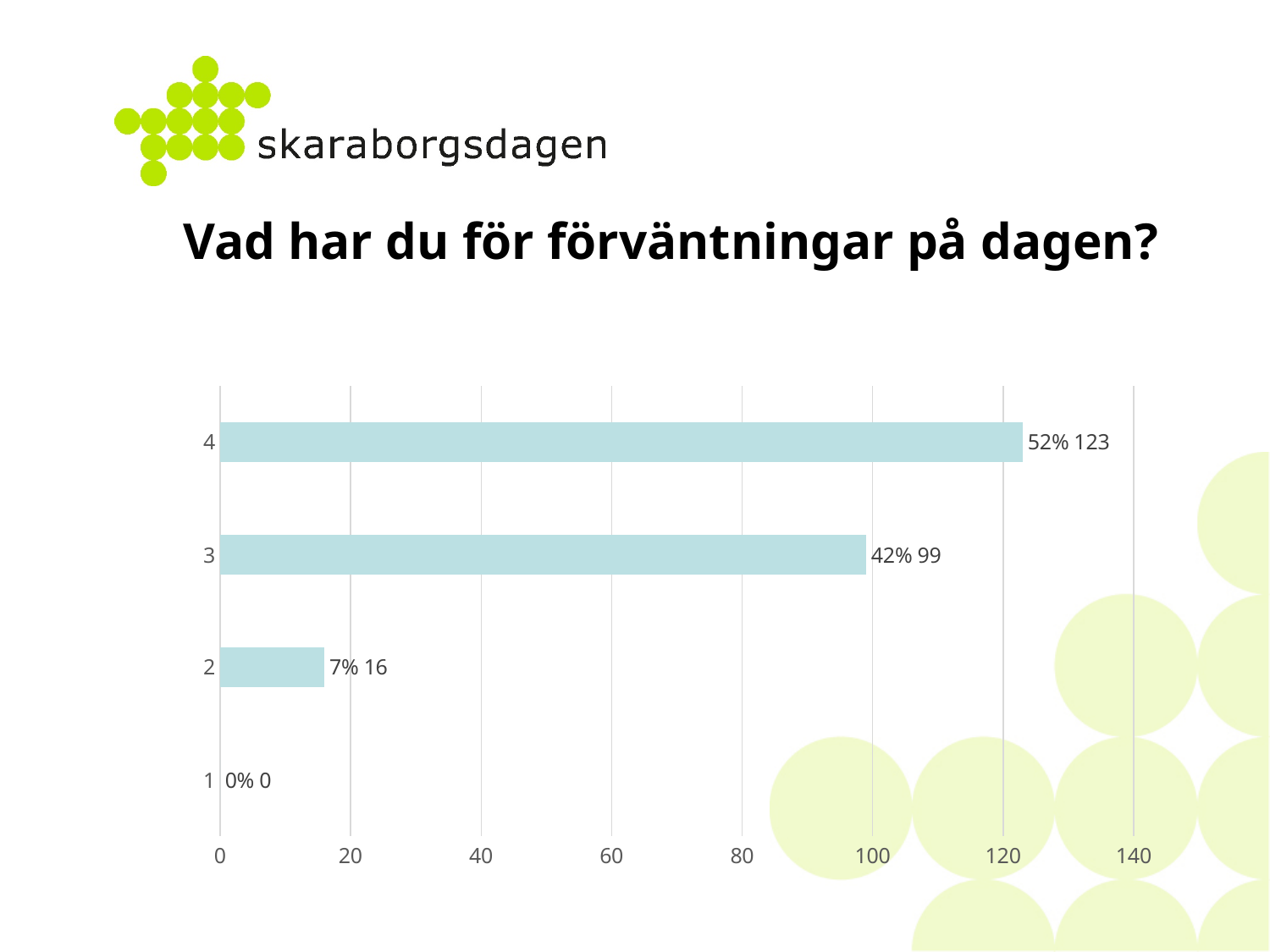
What kind of chart is shown on the slide? bar chart What percentage is shown for category 1? 0% Which has a larger count, category 3 or category 2? 3 What percentage is shown for category 3? 42% What is the title of the slide above the chart? Vad har du för förväntningar på dagen? Is the value for category 3 greater or less than 80? greater What is the difference between the counts for category 4 and category 3? 24 How many categories are shown on the chart? 4 Which category has the highest value? 4 What is the count value for category 2? 16 What is the count value for category 4? 123 Which category has the lowest value? 1